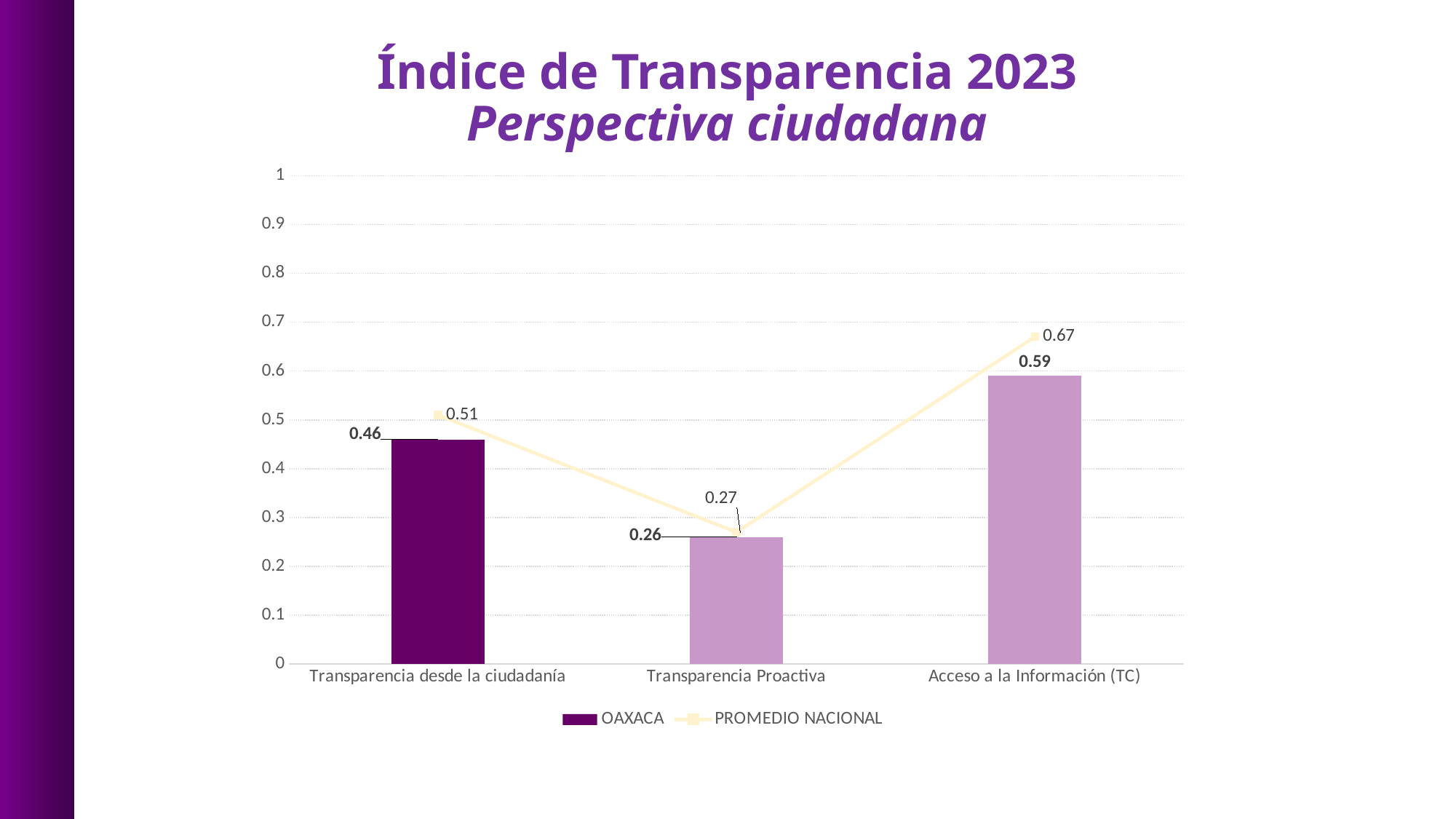
What kind of chart is used for the OAXACA series? bar chart Which category has the lowest PROMEDIO NACIONAL value? Transparencia Proactiva What is the PROMEDIO NACIONAL value for Acceso a la Información (TC)? 0.67 Is the OAXACA value for Acceso a la Información (TC) greater or less than 0.5? greater What is the title of the chart? Índice de Transparencia 2023 Perspectiva ciudadana What is the OAXACA value for Transparencia desde la ciudadanía? 0.46 How many series does the legend list? 2 Which category has the highest OAXACA value? Acceso a la Información (TC) What is the difference between the PROMEDIO NACIONAL and OAXACA values for Acceso a la Información (TC)? 0.08 How many categories are shown on the x axis? 3 For Transparencia desde la ciudadanía, which is larger: the OAXACA value or the PROMEDIO NACIONAL value? PROMEDIO NACIONAL What is the OAXACA value for Transparencia Proactiva? 0.26